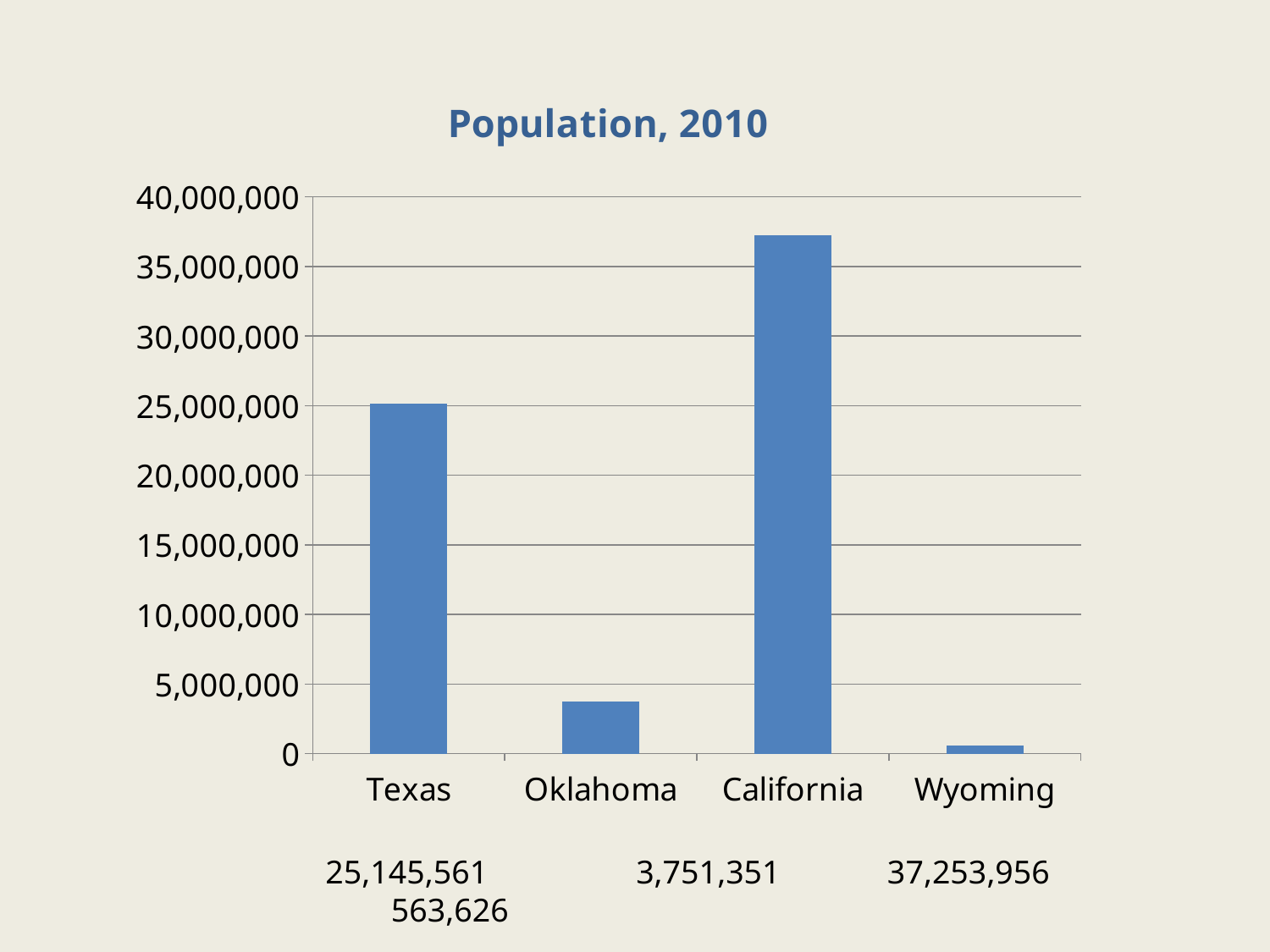
What type of chart is shown on the slide? Bar chart Is the value for Texas greater or less than 20,000,000? greater Which has a larger population, Texas or Oklahoma? Texas Which state has the highest population in the chart? California Is the value for Oklahoma greater or less than 5,000,000? less What is the difference between the populations of California and Texas? 12,108,395 What is the population shown for Oklahoma? 3,751,351 What is the population shown for Texas? 25,145,561 Which state has the lowest population in the chart? Wyoming How many states are shown in the chart? 4 What is the population shown for California? 37,253,956 What is the difference between the populations of Texas and Oklahoma? 21,394,210